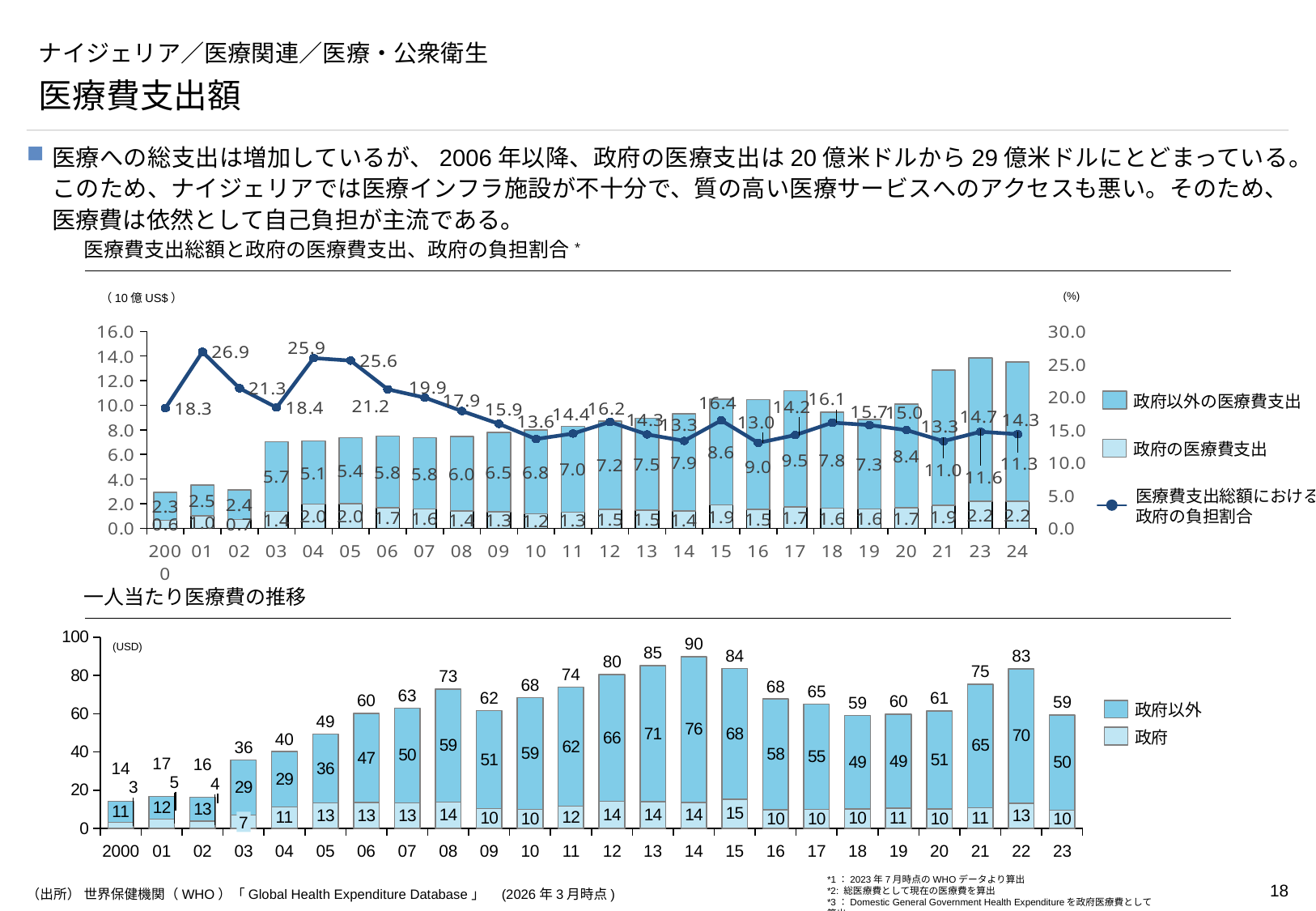
In the top chart (医療費支出総額と政府の医療費支出、政府の負担割合), what is the government share (政府の負担割合) for 2001? 26.9 In the bottom chart, what is the difference between the total for 2014 and the total for 2023? 31 In the bottom chart, which year has the highest total per-capita health expenditure? 2014 In the top chart, what is the total of the stacked bar for 2024 (政府以外 plus 政府)? 13.5 In the bottom chart (一人当たり医療費の推移), what is the total per-capita health expenditure for 2014? 90 In the bottom chart, what is the 政府 (government) value for 2015? 15 In the bottom chart, which year has the larger total: 2008 or 2009? 2008 In the top chart, in which year is the government share line (医療費支出総額における政府の負担割合) highest? 2001 In the top chart, what is the value of 政府の医療費支出 for 2015? 1.9 How many series does the legend of the top chart list? 3 In the top chart, what is the lowest value of the government share line, and in which year? 13.0 in 2016 In the top chart, what is the value of 政府以外の医療費支出 for 2024? 11.3